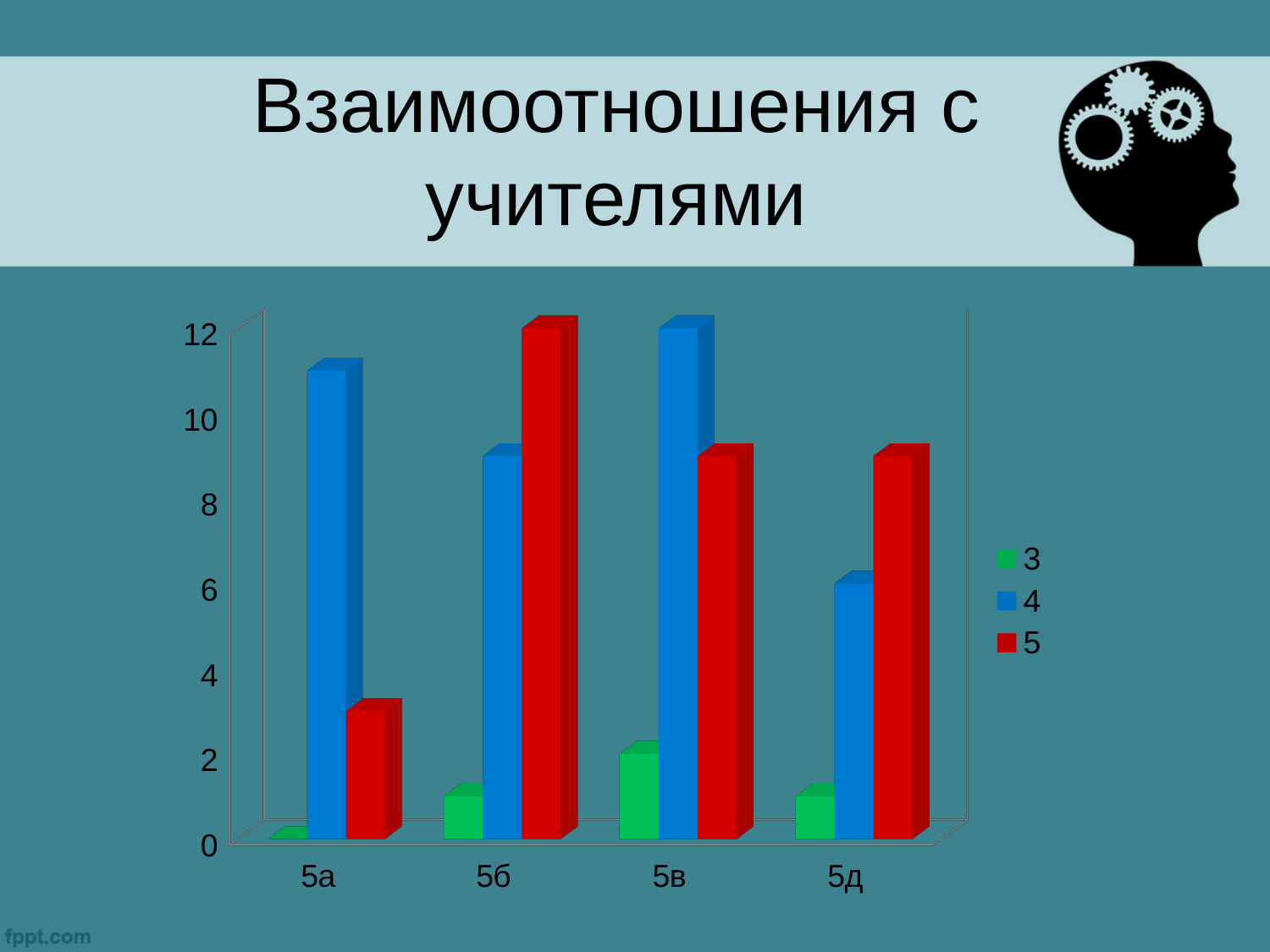
What kind of chart is shown on the slide? bar chart Is the value for series 5 in category 5а greater or less than 4? less Which category has the highest value for series 3? 5в In category 5б, which is larger: the value for series 4 or the value for series 5? series 5 How many categories are shown on the x axis of the chart? 4 Which category has the lowest value for series 4? 5д Is the value for series 4 in category 5д greater or less than 8? less Which category has the highest value for series 5? 5б How many series does the chart's legend list? 3 Is the value for series 4 in category 5а greater or less than 10? greater Which category has the lowest value for series 5? 5а What is the title of the slide containing the chart? Взаимоотношения с учителями